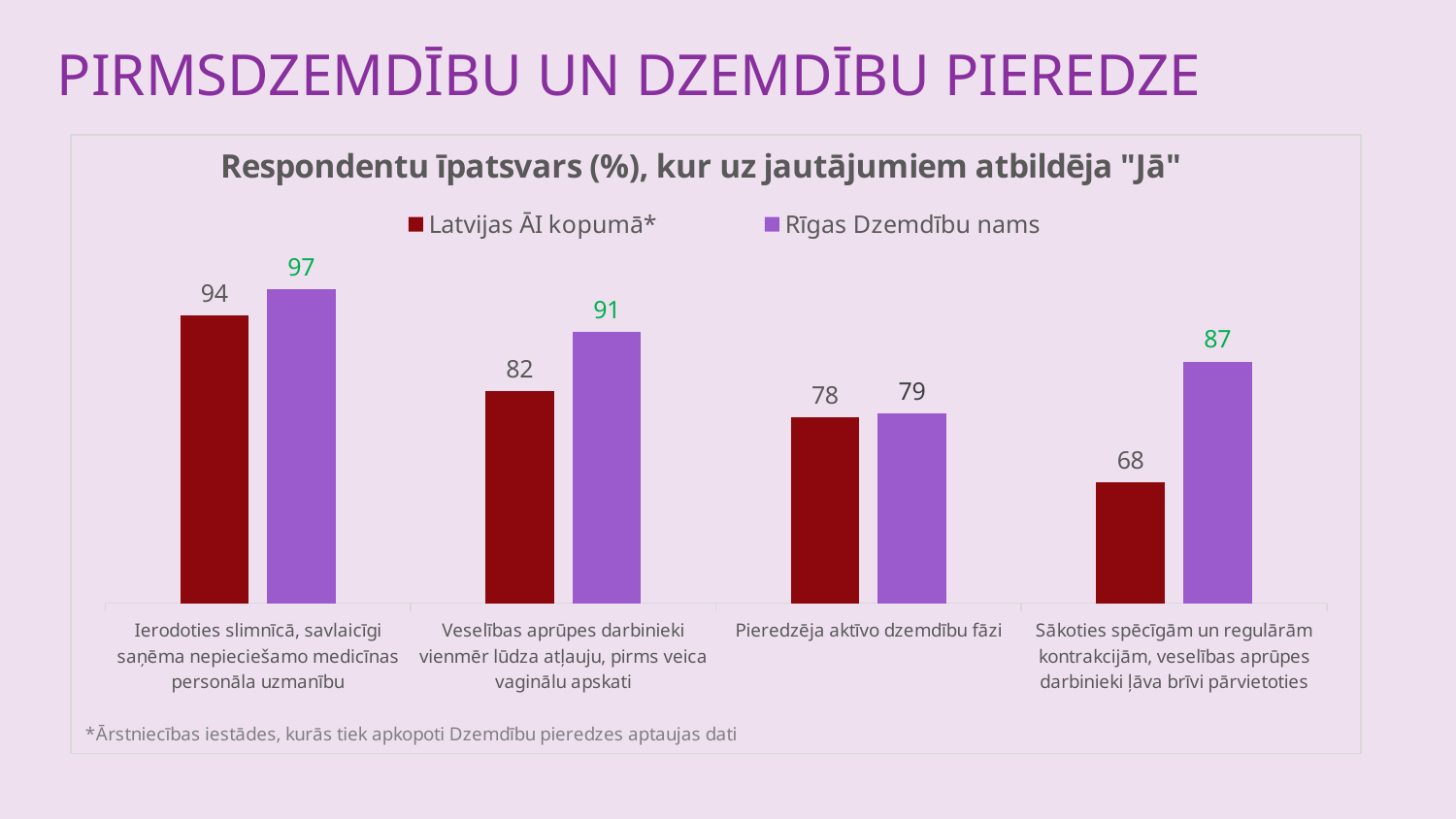
What is the value for Rīgas Dzemdību nams for "Pieredzēja aktīvo dzemdību fāzi"? 79 What is the difference between Rīgas Dzemdību nams and Latvijas ĀI kopumā* for "Sākoties spēcīgām un regulārām kontrakcijām, veselības aprūpes darbinieki ļāva brīvi pārvietoties"? 19 What is the title of the chart? Respondentu īpatsvars (%), kur uz jautājumiem atbildēja "Jā" Which category has the highest value for Rīgas Dzemdību nams? Ierodoties slimnīcā, savlaicīgi saņēma nepieciešamo medicīnas personāla uzmanību How many series does the legend list? 2 What is the difference between Rīgas Dzemdību nams and Latvijas ĀI kopumā* for "Ierodoties slimnīcā, savlaicīgi saņēma nepieciešamo medicīnas personāla uzmanību"? 3 What kind of chart is shown on the slide? Bar chart What is the value for Latvijas ĀI kopumā* for "Veselības aprūpes darbinieki vienmēr lūdza atļauju, pirms veica vaginālu apskati"? 82 Which category has the lowest value for Latvijas ĀI kopumā*? Sākoties spēcīgām un regulārām kontrakcijām, veselības aprūpes darbinieki ļāva brīvi pārvietoties Which series has the larger value for "Veselības aprūpes darbinieki vienmēr lūdza atļauju, pirms veica vaginālu apskati"? Rīgas Dzemdību nams What is the value for Latvijas ĀI kopumā* for "Sākoties spēcīgām un regulārām kontrakcijām, veselības aprūpes darbinieki ļāva brīvi pārvietoties"? 68 How many categories are shown on the x axis? 4